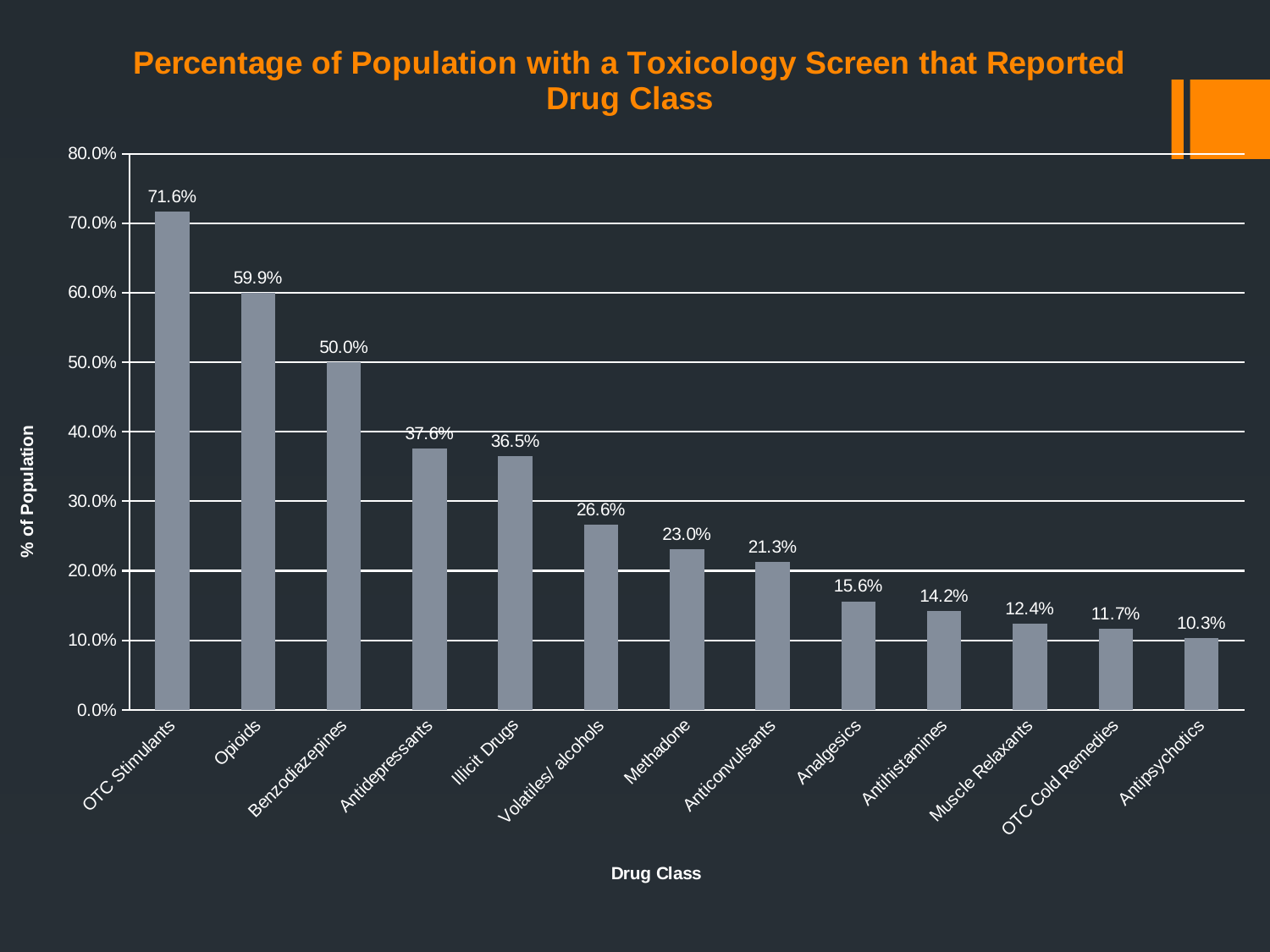
Which drug class has the lowest percentage? Antipsychotics What kind of chart is shown on the slide? Bar chart What is the difference between the percentages for Opioids and Benzodiazepines? 9.9% Which is larger, the value for Illicit Drugs or the value for Volatiles/ alcohols? Illicit Drugs How many drug classes are shown on the chart? 13 What percentage is reported for Antihistamines? 14.2% Is the value for Analgesics greater or less than 20.0%? less What is the value shown for Methadone? 23.0% What percentage of the population had a toxicology screen that reported OTC Stimulants? 71.6% What is the label of the y axis? % of Population Do the values rise or fall moving from left to right along the x axis? Fall Which drug class has the highest percentage? OTC Stimulants